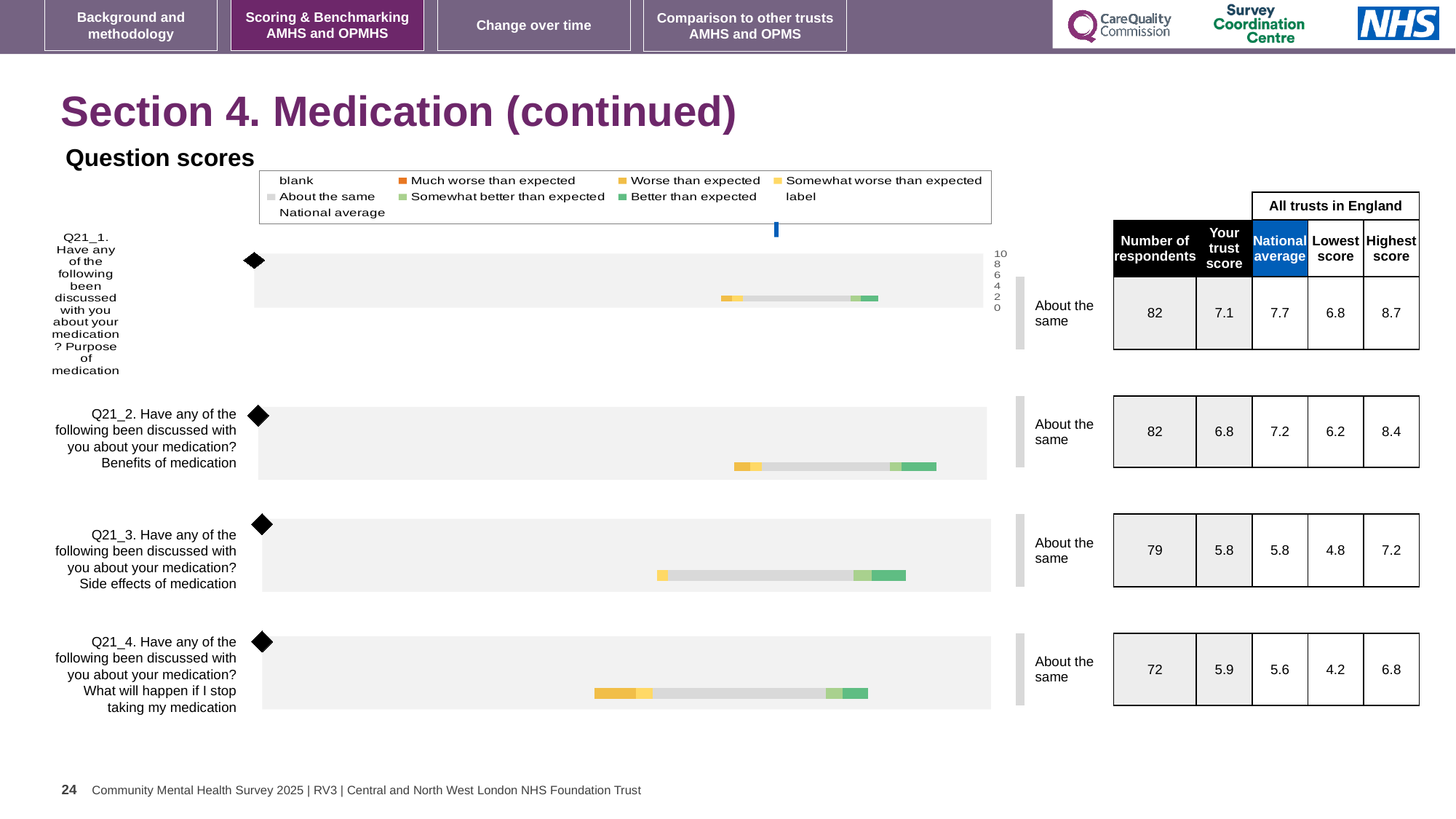
For Q21_4 (What will happen if I stop taking my medication), which is larger: 'Your trust score' or the national average? Your trust score What is the lowest score among all trusts in England for Q21_4 (What will happen if I stop taking my medication)? 4.2 Which question has the highest 'Your trust score'? Q21_1. Purpose of medication Which question has the lowest number of respondents? Q21_4. What will happen if I stop taking my medication What kind of chart is used to show the question scores on this slide? bar chart What is the national average for Q21_2 (Benefits of medication)? 7.2 What is the 'Your trust score' for Q21_1 (Purpose of medication)? 7.1 How many respondents answered Q21_3 (Side effects of medication)? 79 What benchmark category is shown next to each of the four question bars? About the same How many question bars (Q21_1 to Q21_4) are plotted on the slide? 4 What is the highest score among all trusts in England for Q21_3 (Side effects of medication)? 7.2 What is the difference between the national average and 'Your trust score' for Q21_1 (Purpose of medication)? 0.6